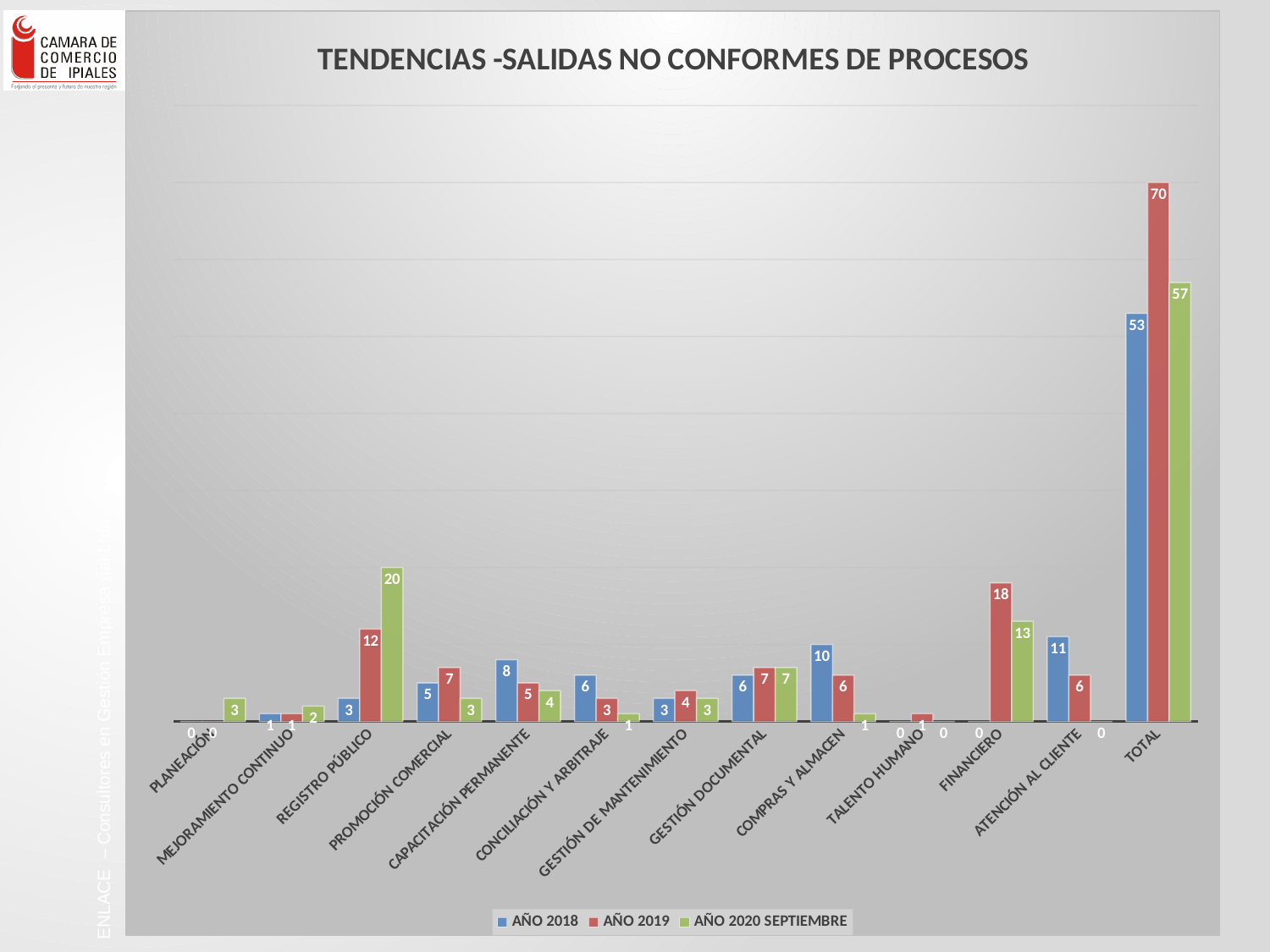
What is the value for TOTAL in the AÑO 2019 series? 70 What is the value for ATENCIÓN AL CLIENTE in the AÑO 2018 series? 11 What kind of chart is shown on the slide? Bar chart What is the difference between the AÑO 2019 and AÑO 2018 values for TOTAL? 17 What is the value for REGISTRO PÚBLICO in the AÑO 2020 SEPTIEMBRE series? 20 Excluding TOTAL, which category has the highest value in the AÑO 2020 SEPTIEMBRE series? REGISTRO PÚBLICO What is the value for FINANCIERO in the AÑO 2019 series? 18 Which is larger for FINANCIERO: the AÑO 2019 value or the AÑO 2020 SEPTIEMBRE value? AÑO 2019 How many series does the legend list? 3 Excluding TOTAL, which category has the highest value in the AÑO 2018 series? ATENCIÓN AL CLIENTE What is the title of the chart? TENDENCIAS -SALIDAS NO CONFORMES DE PROCESOS How many categories are shown on the x axis? 13